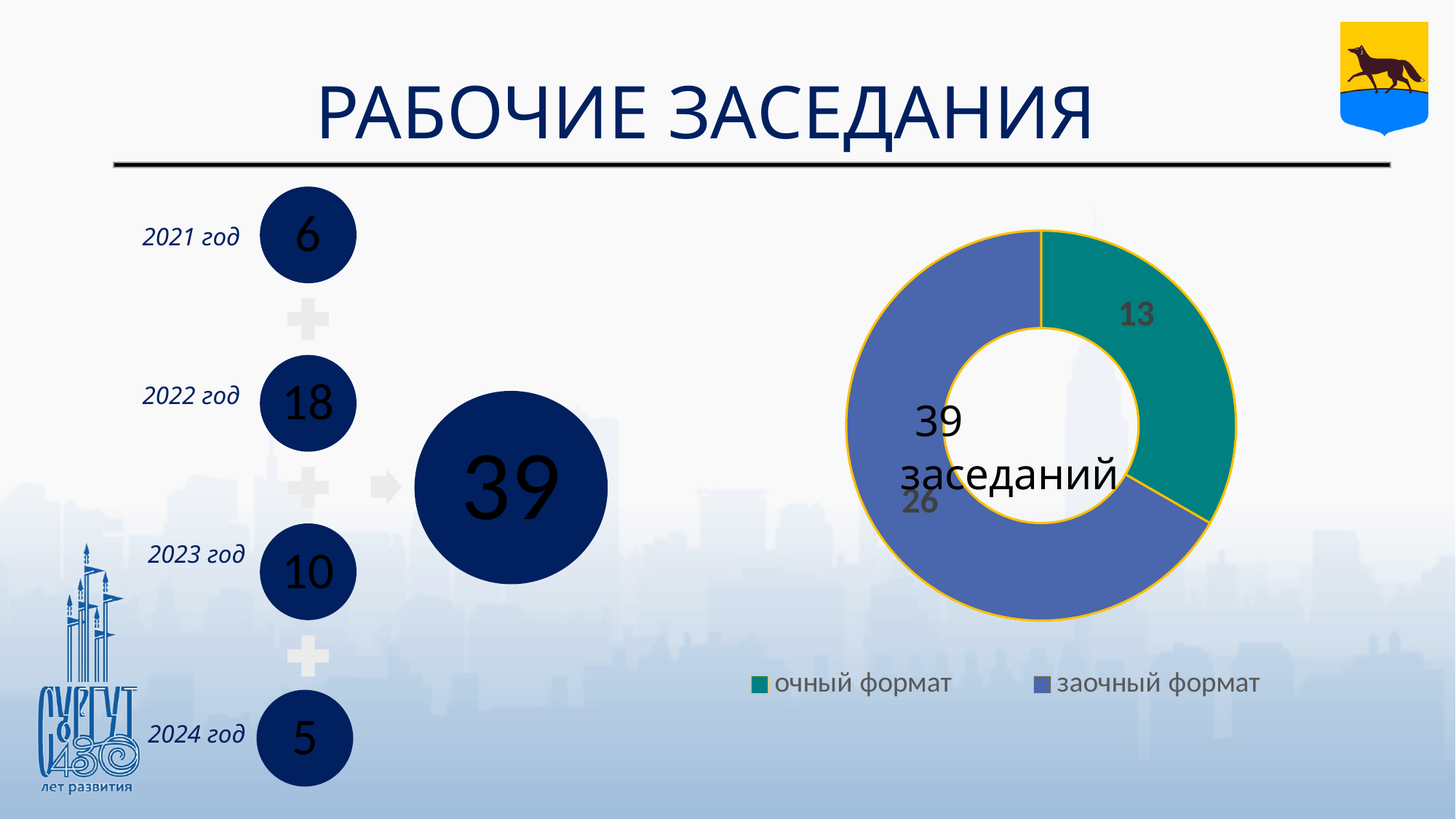
Which format has the larger slice in the donut chart? заочный формат Is the value for заочный формат larger or smaller than the value for очный формат? larger What share of the donut chart does заочный формат represent? two thirds What is the difference between the заочный формат and очный формат values in the donut chart? 13 What colour is the очный формат slice in the donut chart? Teal (green) What kind of chart is shown on the slide? Donut (pie) chart What is the title of the slide containing the donut chart? РАБОЧИЕ ЗАСЕДАНИЯ What is the value for заочный формат in the donut chart? 26 How many series does the legend of the donut chart list? 2 Which format has the smaller slice in the donut chart? очный формат What is the value for очный формат in the donut chart? 13 What total number of meetings is shown in the centre of the donut chart? 39 заседаний